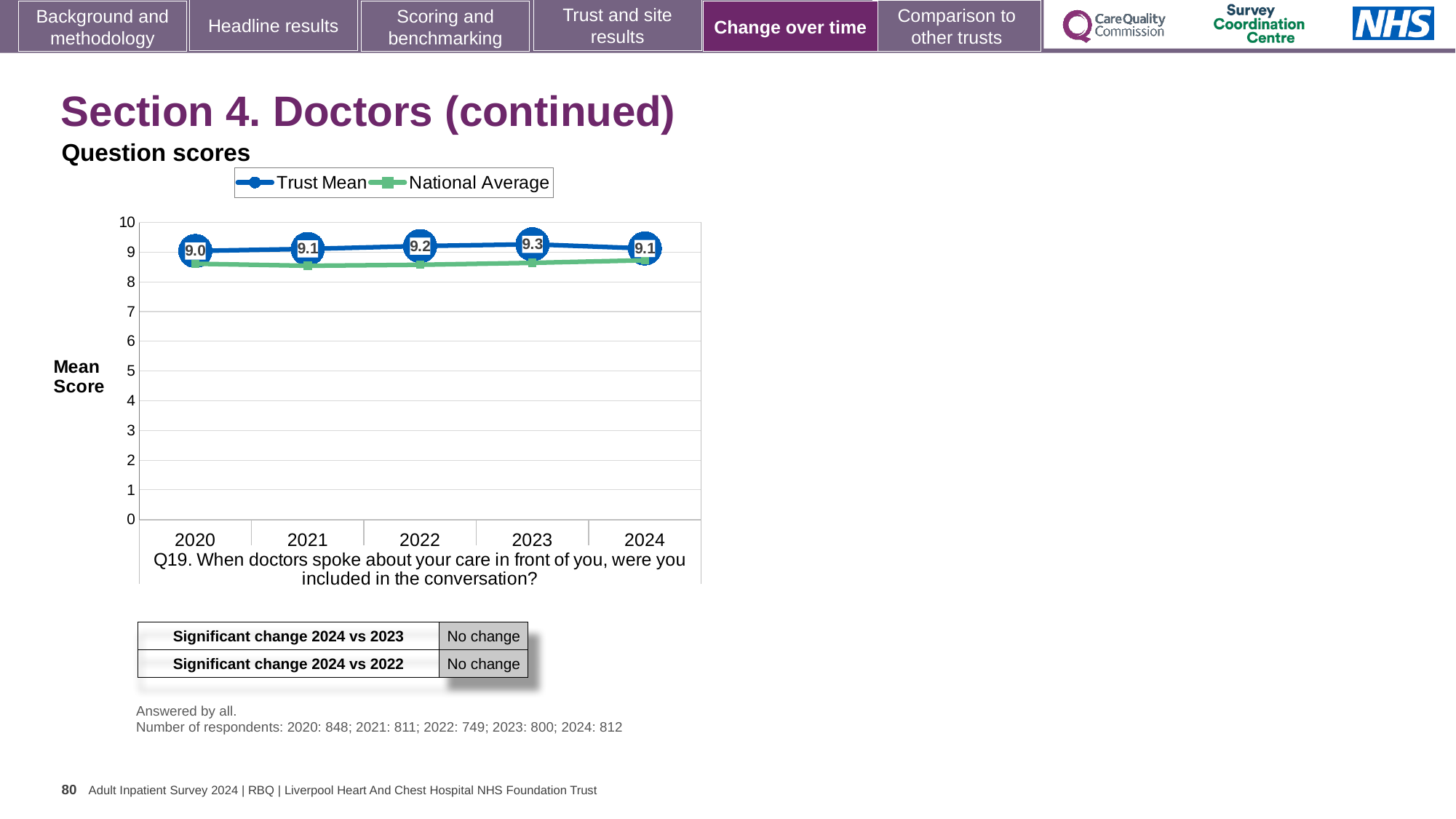
What is the Trust Mean score for 2024? 9.1 What kind of chart is shown? line chart How many series does the legend list? 2 Is the National Average value for 2021 greater or less than 9? less Does the Trust Mean rise or fall from 2020 to 2023? rise In which year is the Trust Mean highest? 2023 Which is larger, the Trust Mean in 2022 or in 2024? 2022 What is the Trust Mean score for 2020? 9.0 How many years are shown on the x axis? 5 What is the Trust Mean score for 2023? 9.3 In which year is the Trust Mean lowest? 2020 What is the difference between the Trust Mean in 2023 and in 2020? 0.3